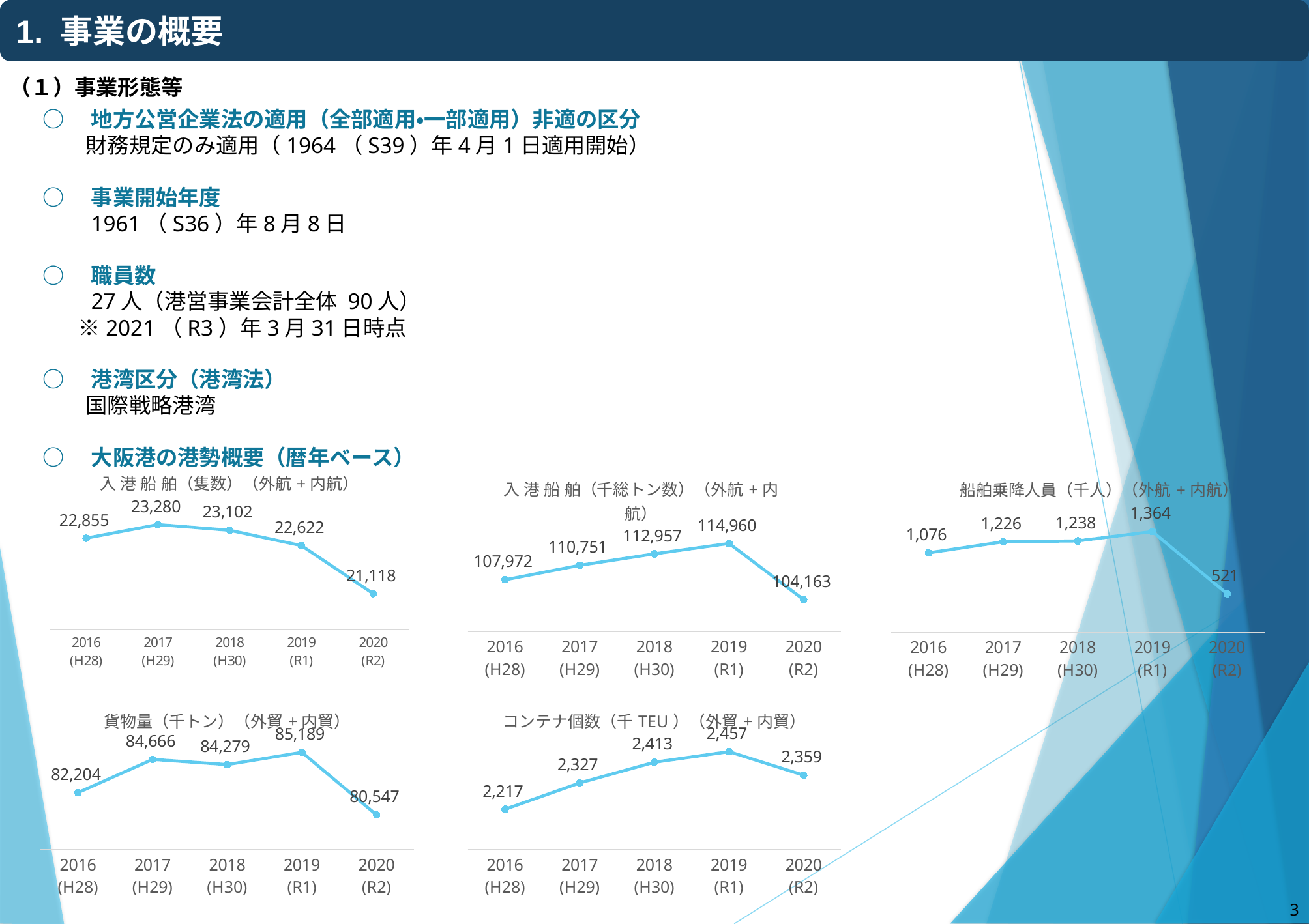
In the chart titled コンテナ個数（千TEU）（外貿＋内貿）, what is the value for 2018 (H30)? 2,413 In the chart titled 入港船舶（千総トン数）（外航＋内航）, what is the value for 2019 (R1)? 114,960 In the chart titled 貨物量（千トン）（外貿＋内貿）, which is larger, the value for 2017 (H29) or the value for 2018 (H30)? 2017 (H29) What type of chart is the chart titled 貨物量（千トン）（外貿＋内貿）? Line chart In the chart titled コンテナ個数（千TEU）（外貿＋内貿）, what is the difference between the 2019 (R1) value and the 2016 (H28) value? 240 In the chart titled 入港船舶（千総トン数）（外航＋内航）, which year has the lowest value? 2020 (R2) In the chart titled 入港船舶（隻数）（外航＋内航）, which year has the highest value? 2017 (H29) In the chart titled 入港船舶（隻数）（外航＋内航）, what is the value for 2020 (R2)? 21,118 In the chart titled 船舶乗降人員（千人）（外航＋内航）, what is the difference between the 2019 (R1) value and the 2020 (R2) value? 843 In the chart titled 貨物量（千トン）（外貿＋内貿）, which year has the highest value? 2019 (R1) How many data points does the chart titled コンテナ個数（千TEU）（外貿＋内貿） show? 5 In the chart titled 船舶乗降人員（千人）（外航＋内航）, what is the value for 2016 (H28)? 1,076